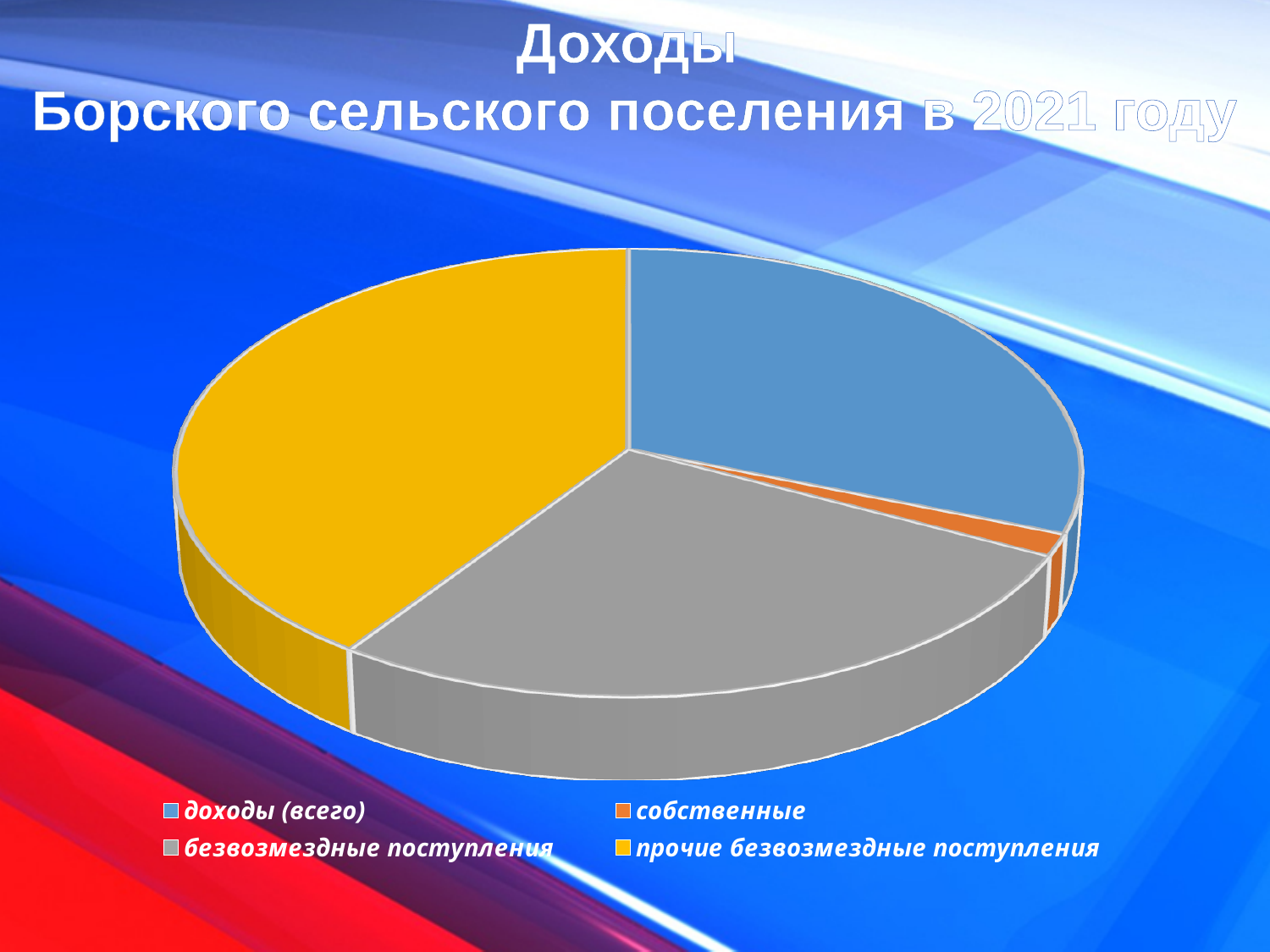
What colour is the slice for прочие безвозмездные поступления in the pie chart? yellow What is the title of the slide containing the pie chart? Доходы Борского сельского поселения в 2021 году Which is larger in the pie chart: the slice for прочие безвозмездные поступления or the slice for собственные? прочие безвозмездные поступления How many entries does the legend of the pie chart list? 4 Which slice of the pie chart is the smallest? собственные How many slices does the pie chart have? 4 What kind of chart is shown on the slide? pie chart Which is larger in the pie chart: the slice for безвозмездные поступления or the slice for собственные? безвозмездные поступления Which is larger in the pie chart: the slice for доходы (всего) or the slice for собственные? доходы (всего)